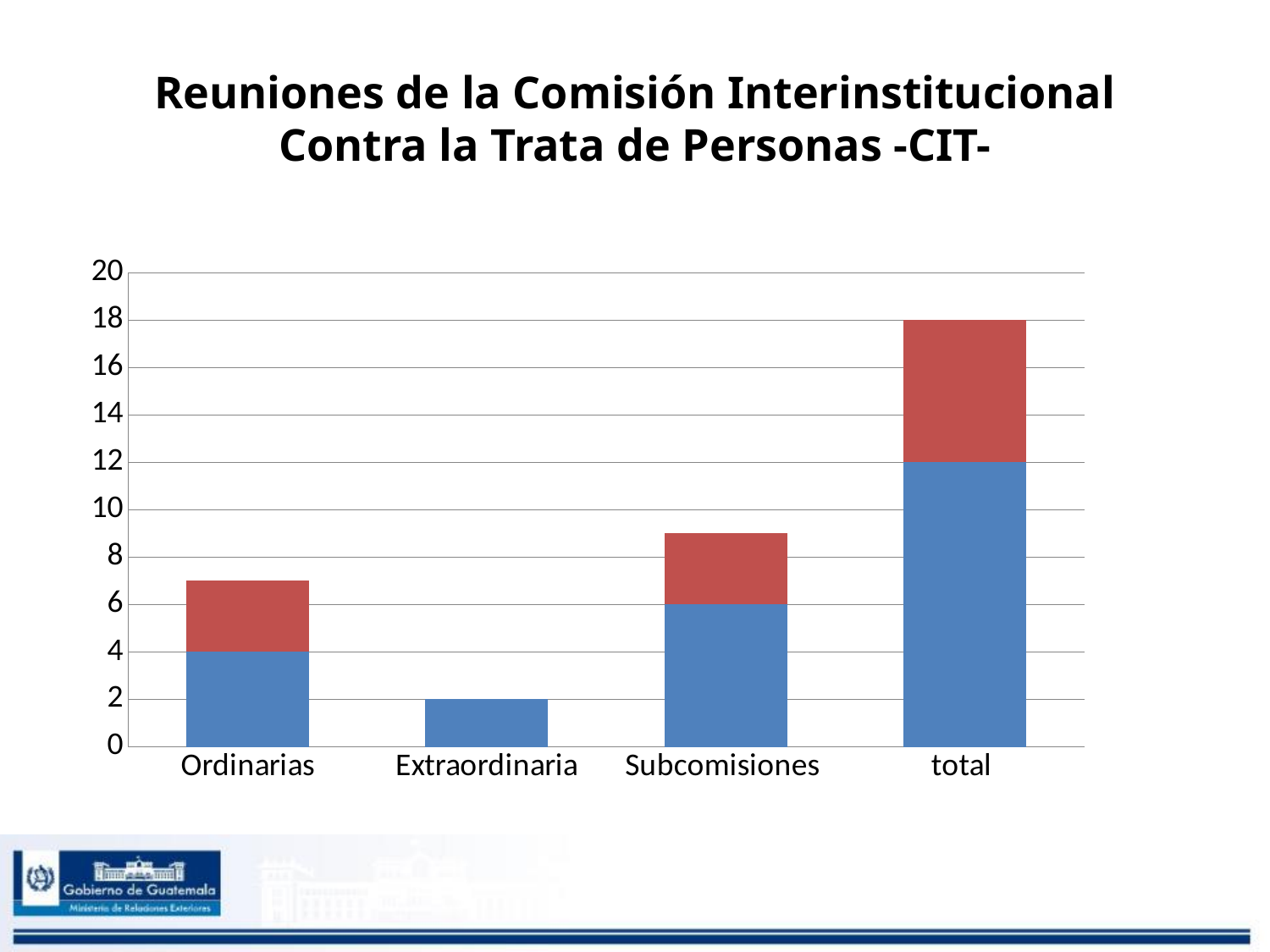
Which bar is taller, Subcomisiones or Ordinarias? Subcomisiones How many categories are shown on the x axis of the chart? 4 What is the total height of the stacked bar for total? 18 What is the difference between the blue segment for total and the blue segment for Subcomisiones? 6 What is the value of the blue segment for Subcomisiones? 6 Which category has the tallest bar in the chart? total What is the value of the blue segment for total? 12 What is the value of the blue segment for Ordinarias? 4 What is the value of the blue segment for Extraordinaria? 2 Is the total height of the bar for Subcomisiones greater or less than 10? less Which category has the shortest bar in the chart? Extraordinaria What kind of chart is shown on the slide? bar chart